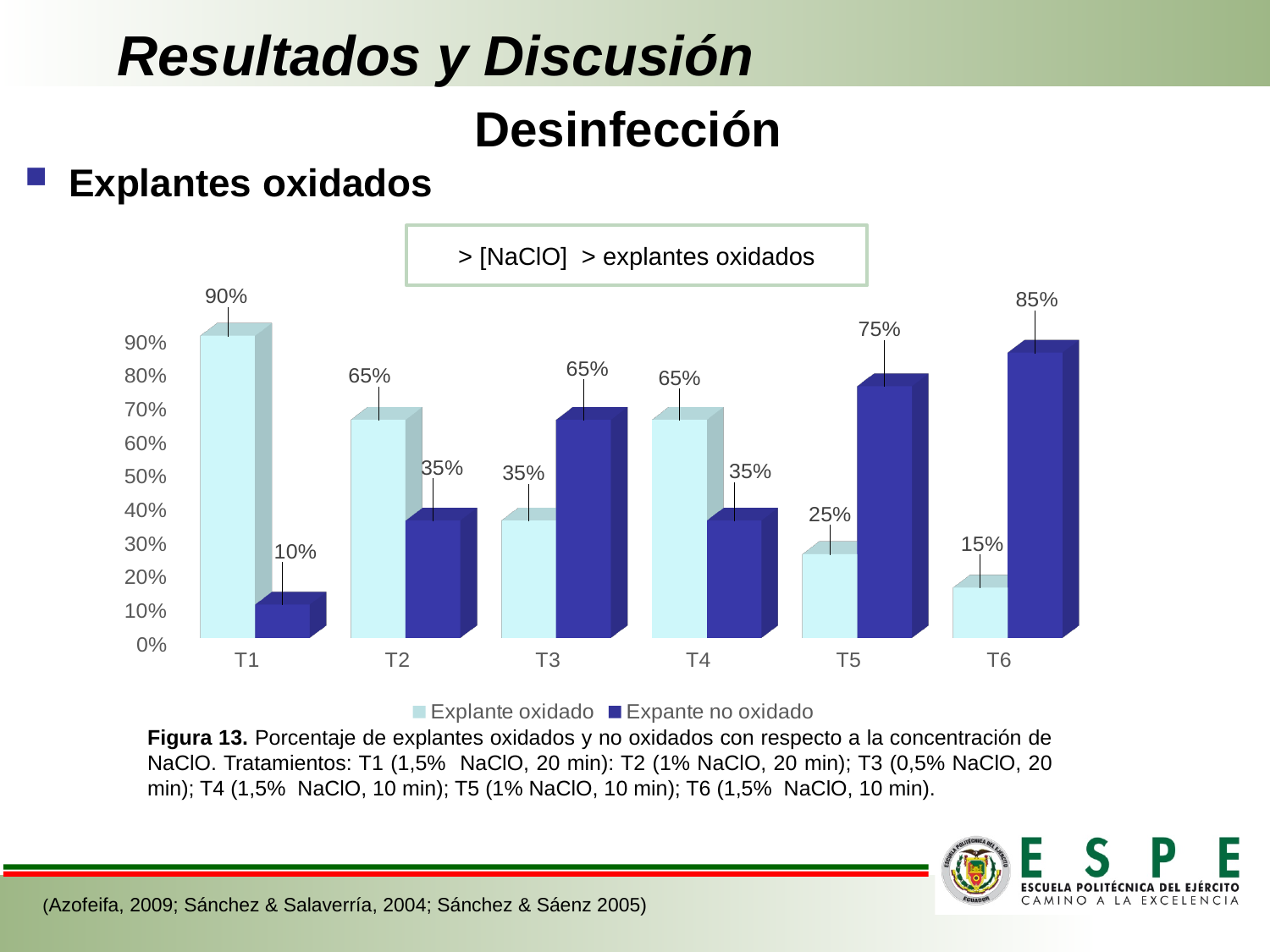
Which is larger at T4: Explante oxidado or Expante no oxidado? Explante oxidado What is the difference between the Explante oxidado values at T1 and T6? 75% Which treatment has the lowest value for Expante no oxidado? T1 How many treatments are shown on the x axis? 6 What is the value for Explante oxidado at T6? 15% What is the value for Explante oxidado at T1? 90% What kind of chart is shown? Bar chart What is the value for Expante no oxidado at T3? 65% What is the value for Expante no oxidado at T5? 75% Which treatment has the highest value for Explante oxidado? T1 How many series does the legend list? 2 What is the text in the box above the chart? > [NaClO] > explantes oxidados